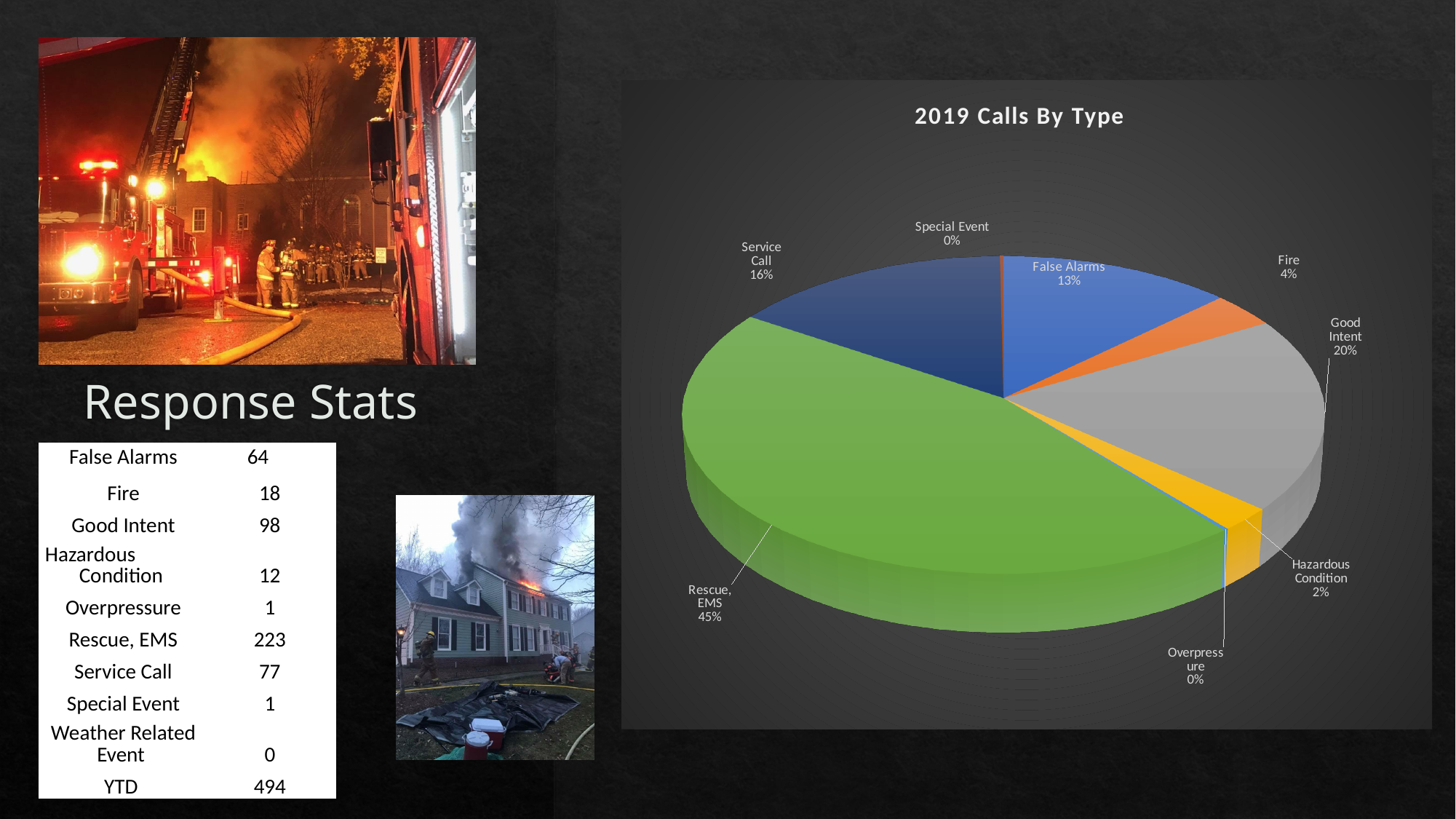
What percentage is shown for False Alarms in the pie chart? 13% What percentage is shown for Fire in the pie chart? 4% What percentage is shown for Service Call in the pie chart? 16% What percentage is shown for Good Intent in the pie chart? 20% What kind of chart is shown on the slide? pie chart Which call type has the largest share of the pie? Rescue, EMS What share of the pie does Rescue, EMS represent? 45% Which is larger in the pie chart, Service Call or False Alarms? Service Call What is the title of the pie chart? 2019 Calls By Type How many call types are labeled on the pie chart? 8 What is the difference in percentage points between Good Intent and Fire in the pie chart? 16 What percentage is shown for Hazardous Condition in the pie chart? 2%